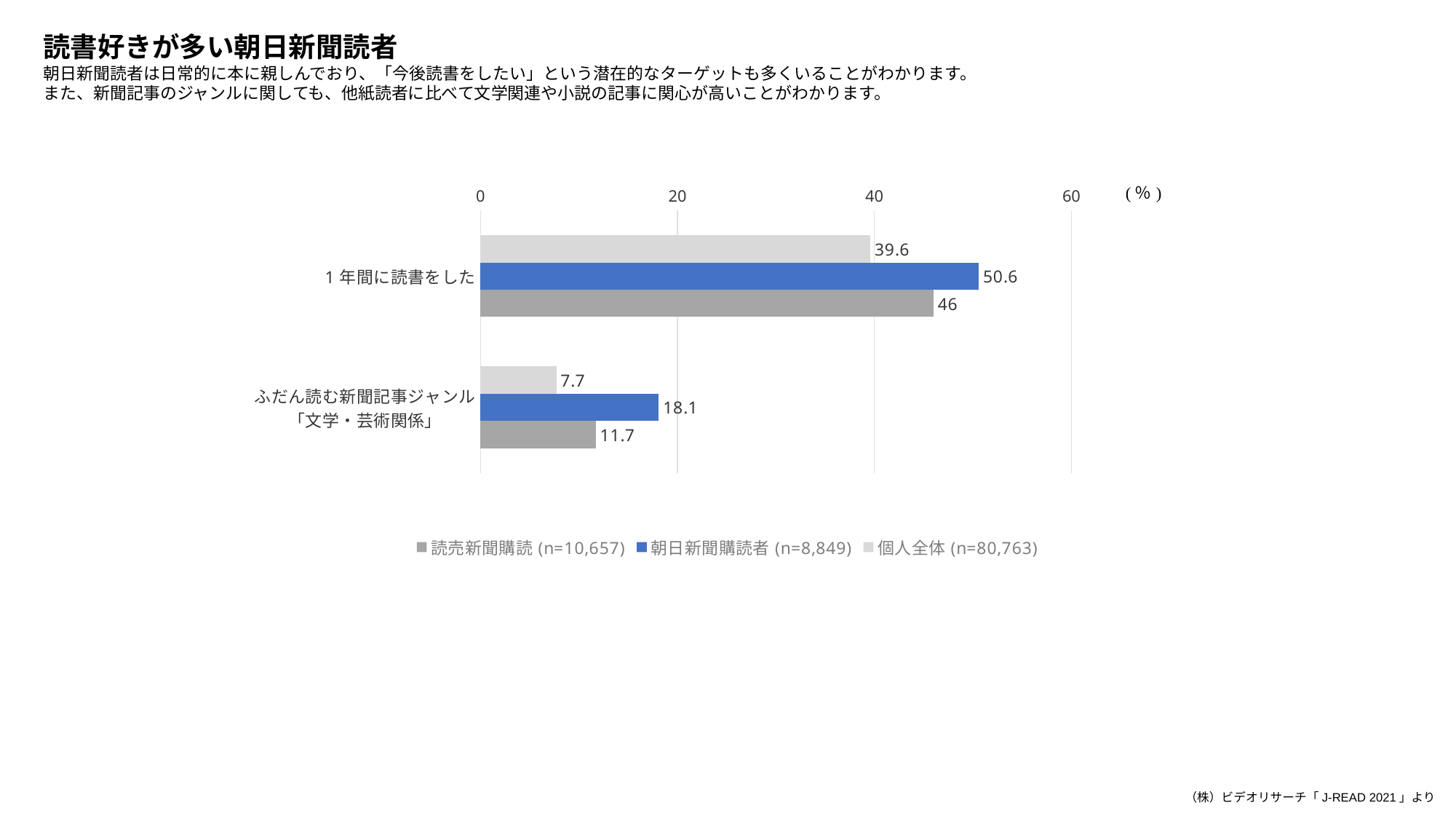
Which series has the lowest value in the ふだん読む新聞記事ジャンル「文学・芸術関係」 category? 個人全体 What is the value for 個人全体 in the ふだん読む新聞記事ジャンル「文学・芸術関係」 category? 7.7 How many series does the legend list? 3 What kind of chart is shown on the slide? Bar chart What is the value for 朝日新聞購読者 in the ふだん読む新聞記事ジャンル「文学・芸術関係」 category? 18.1 How many categories are shown on the chart? 2 What is the value for 朝日新聞購読者 in the 1年間に読書をした category? 50.6 Which series has the highest value in the 1年間に読書をした category? 朝日新聞購読者 What is the difference between 朝日新聞購読者 and 読売新聞購読 in the ふだん読む新聞記事ジャンル「文学・芸術関係」 category? 6.4 Which is larger in the 1年間に読書をした category: 読売新聞購読 or 個人全体? 読売新聞購読 What is the difference between 朝日新聞購読者 and 個人全体 in the 1年間に読書をした category? 11 What is the value for 読売新聞購読 in the 1年間に読書をした category? 46